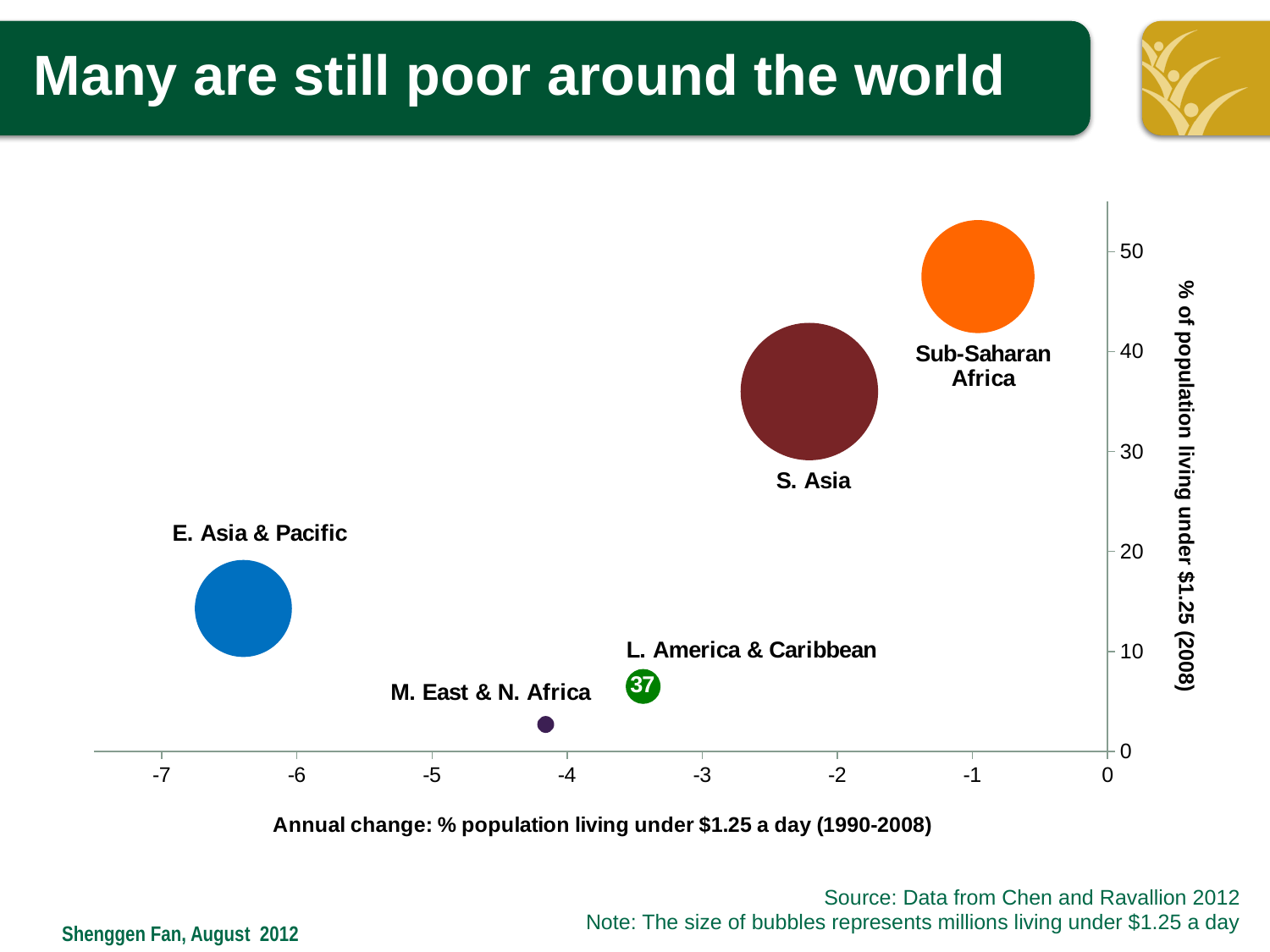
Is the % of population living under $1.25 for S. Asia greater or less than 30? greater Is the annual change for E. Asia & Pacific greater or less than -6? less How many regions are plotted as bubbles on the chart? 5 Is the % of population living under $1.25 for E. Asia & Pacific greater or less than 20? less What kind of chart is shown on the slide? bubble chart Which region has the most negative annual change in % population living under $1.25 a day (1990-2008)? E. Asia & Pacific Which region has a higher % of population living under $1.25 in 2008, S. Asia or E. Asia & Pacific? S. Asia According to the note, what does the size of the bubbles represent? millions living under $1.25 a day What number is printed on the L. America & Caribbean bubble? 37 Which region has the lowest % of population living under $1.25 in 2008? M. East & N. Africa Which region has the highest % of population living under $1.25 in 2008? Sub-Saharan Africa